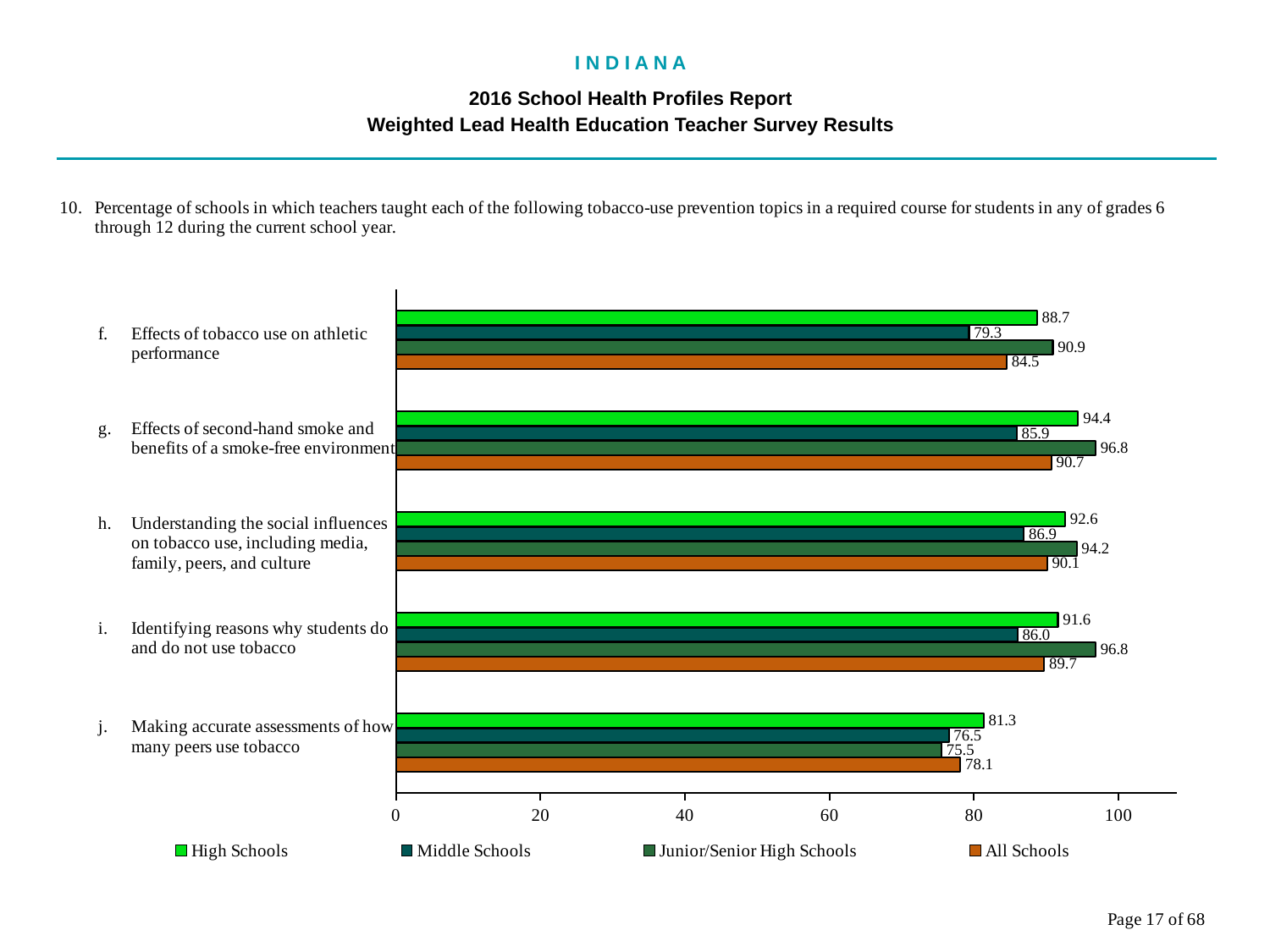
What kind of chart is shown on the slide? bar chart How many series does the legend list? 4 How many topics are shown on the chart? 5 Which school type has the highest value for 'Understanding the social influences on tobacco use, including media, family, peers, and culture'? Junior/Senior High Schools What is the value for High Schools for 'Effects of tobacco use on athletic performance'? 88.7 Is the Middle Schools value for 'Effects of tobacco use on athletic performance' greater or less than 80? less What is the value for Middle Schools for 'Making accurate assessments of how many peers use tobacco'? 76.5 What is the value for All Schools for 'Effects of second-hand smoke and benefits of a smoke-free environment'? 90.7 Which topic has the lowest value for High Schools? Making accurate assessments of how many peers use tobacco What is the difference between the High Schools and Middle Schools values for 'Effects of tobacco use on athletic performance'? 9.4 What is the value for Junior/Senior High Schools for 'Identifying reasons why students do and do not use tobacco'? 96.8 Which is larger for 'Making accurate assessments of how many peers use tobacco': the Middle Schools value or the All Schools value? All Schools